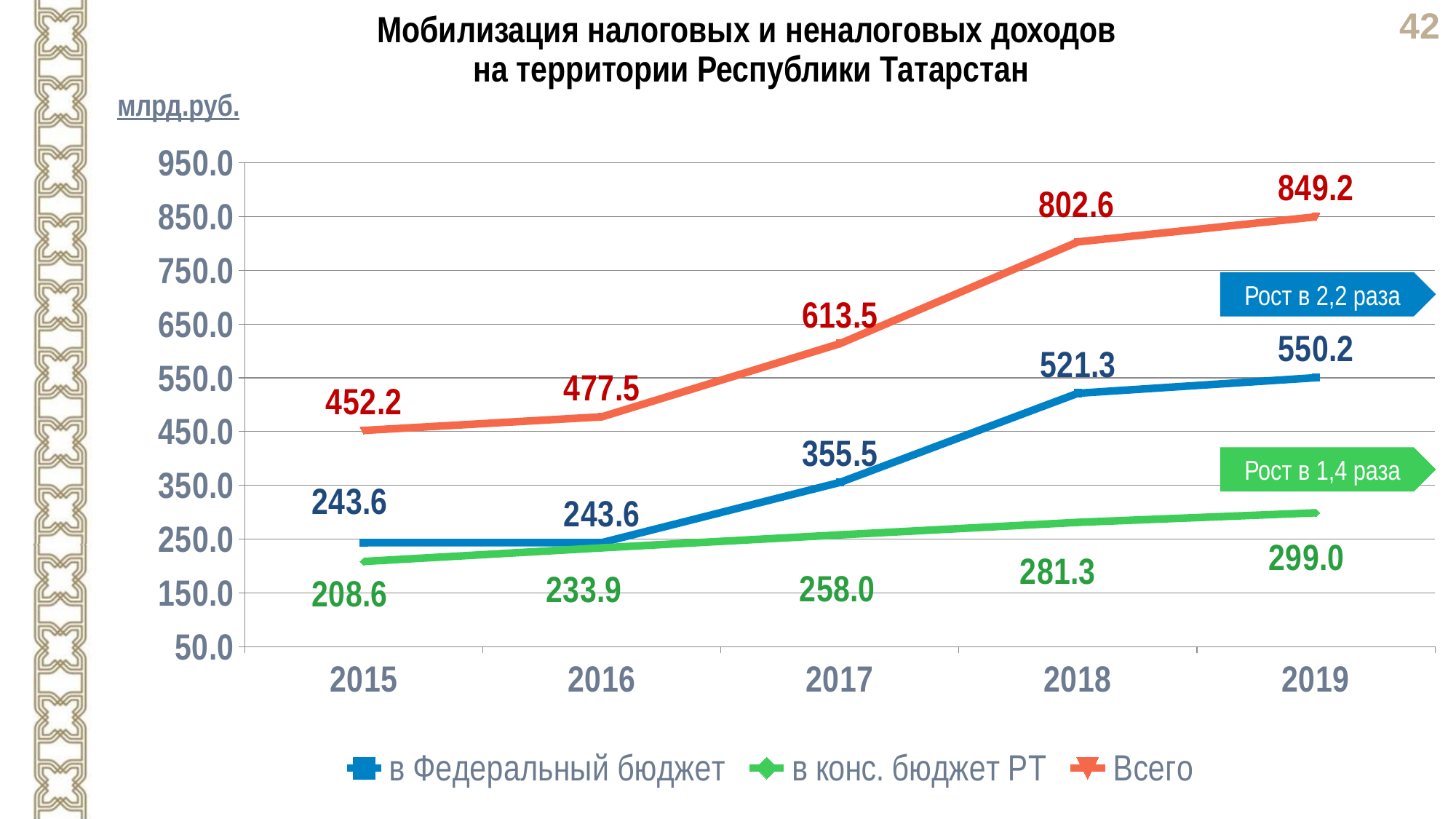
In which year is the 'в Федеральный бюджет' series highest? 2019 Does the 'в конс. бюджет РТ' series rise or fall from 2015 to 2019? rise How many series does the legend list? 3 Which is larger in 2018: 'в Федеральный бюджет' or 'в конс. бюджет РТ'? в Федеральный бюджет What type of chart is shown on the slide? line chart What is the value of the 'в конс. бюджет РТ' series in 2016? 233.9 How many years are shown on the x axis? 5 What is the value of the 'Всего' series in 2019? 849.2 In which year is the 'Всего' series lowest? 2015 What is the value of the 'в Федеральный бюджет' series in 2017? 355.5 What is the difference between the 'Всего' values in 2018 and 2017? 189.1 What unit is indicated above the chart? млрд.руб.